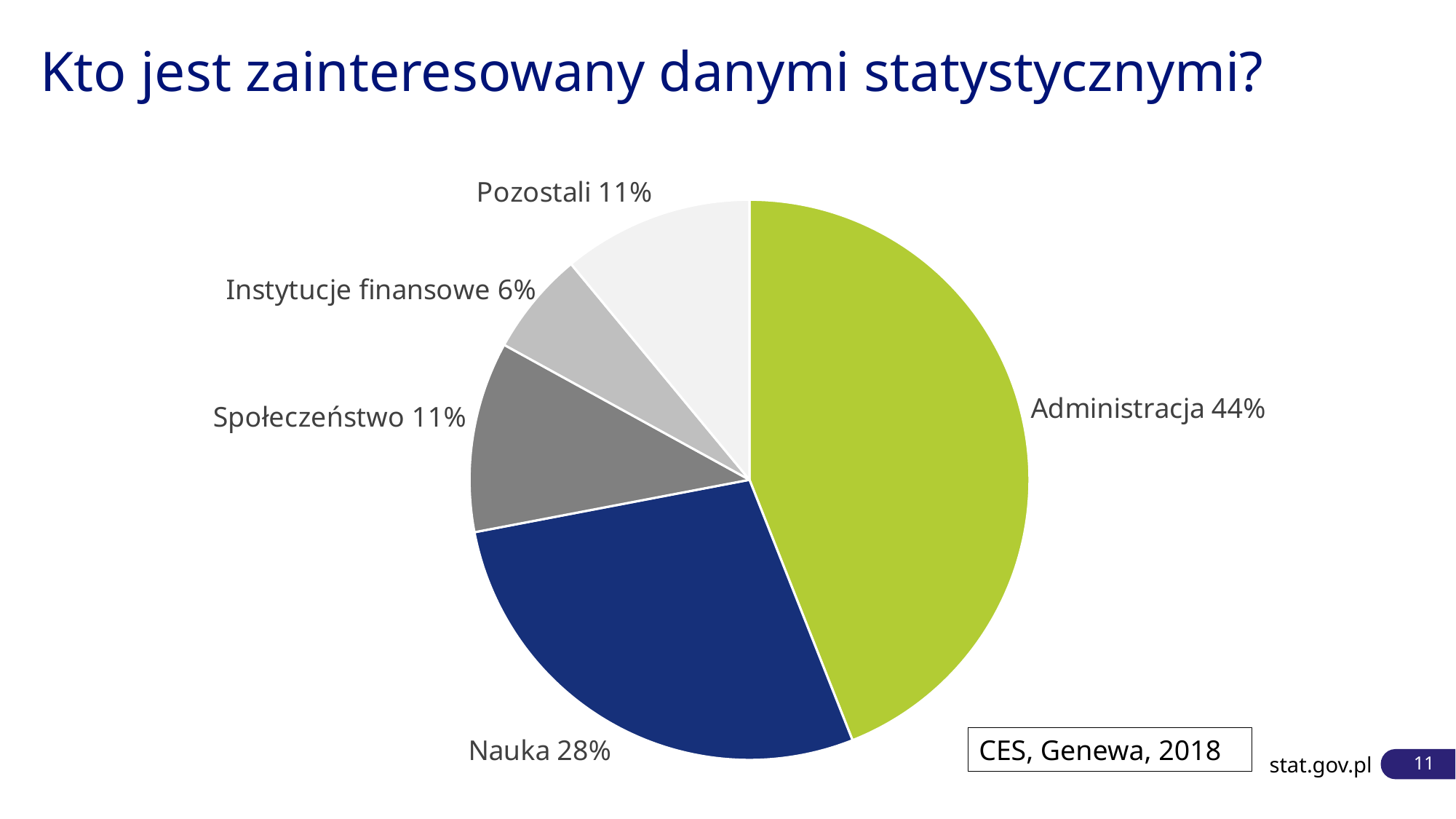
What is the value shown for Społeczeństwo? 11% What share of the pie does Administracja account for? 44% What is the value shown for Instytucje finansowe? 6% What kind of chart is shown on the slide? Pie chart What is the difference in percentage points between Administracja and Nauka? 16 How many categories are shown in the pie chart? 5 Which category has the smallest slice of the pie? Instytucje finansowe What colour is the Administracja slice? Green What is the value shown for Nauka? 28% Which category has the largest slice of the pie? Administracja Which is larger, the slice for Nauka or the slice for Pozostali? Nauka What is the combined share of Administracja and Nauka? 72%